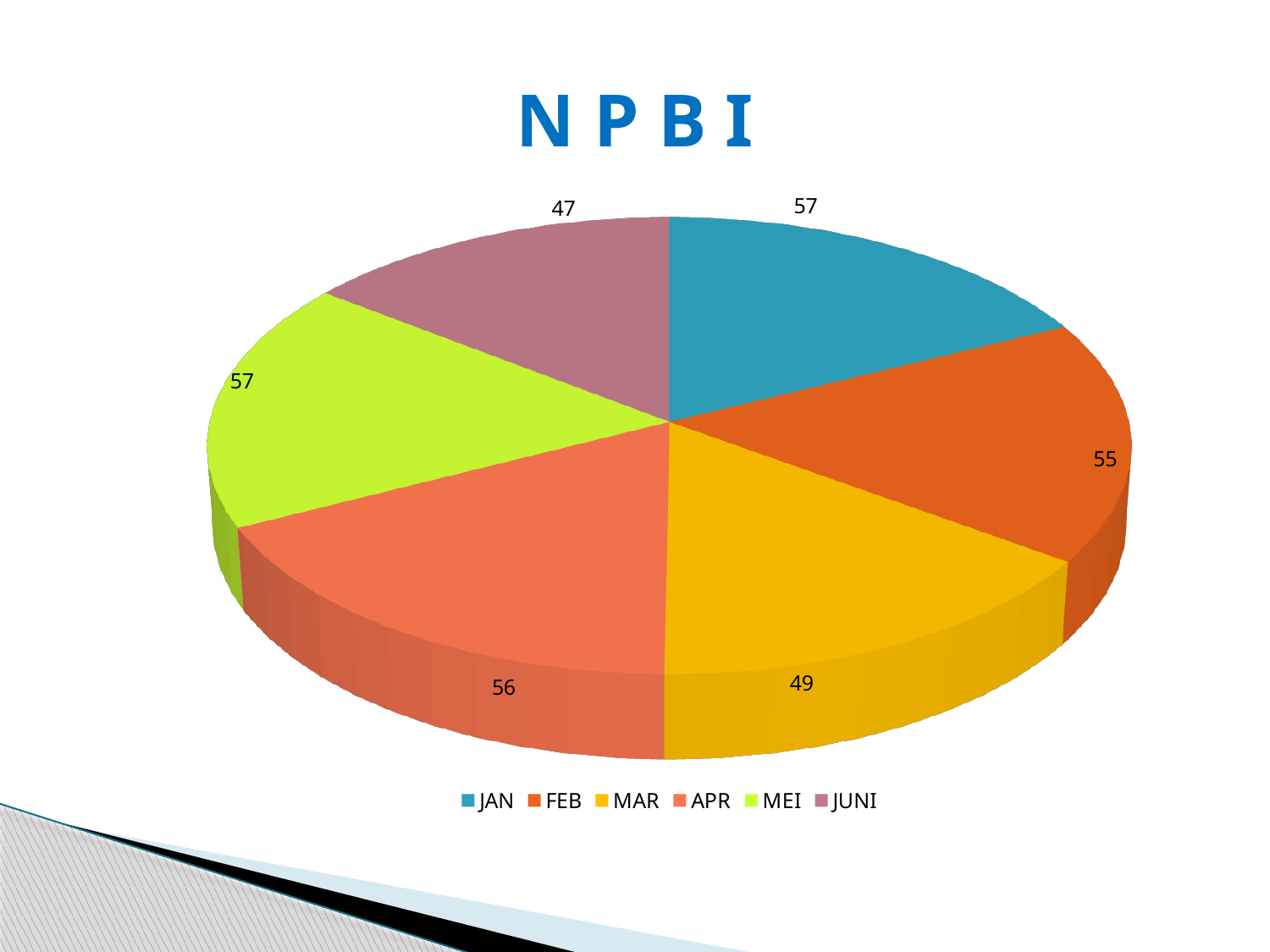
What is the value for JAN in the pie chart? 57 What is the difference between the values for FEB and MAR? 6 Which is larger, the value for APR or the value for JUNI? APR What is the value for MAR in the pie chart? 49 Which is larger, the value for FEB or the value for MAR? FEB What is the value for JUNI in the pie chart? 47 What is the difference between the values for JAN and JUNI? 10 What kind of chart is shown on the slide? Pie chart What is the title of the chart? N P B I Which month has the smallest slice in the pie chart? JUNI What is the value for APR in the pie chart? 56 How many slices does the pie chart have? 6